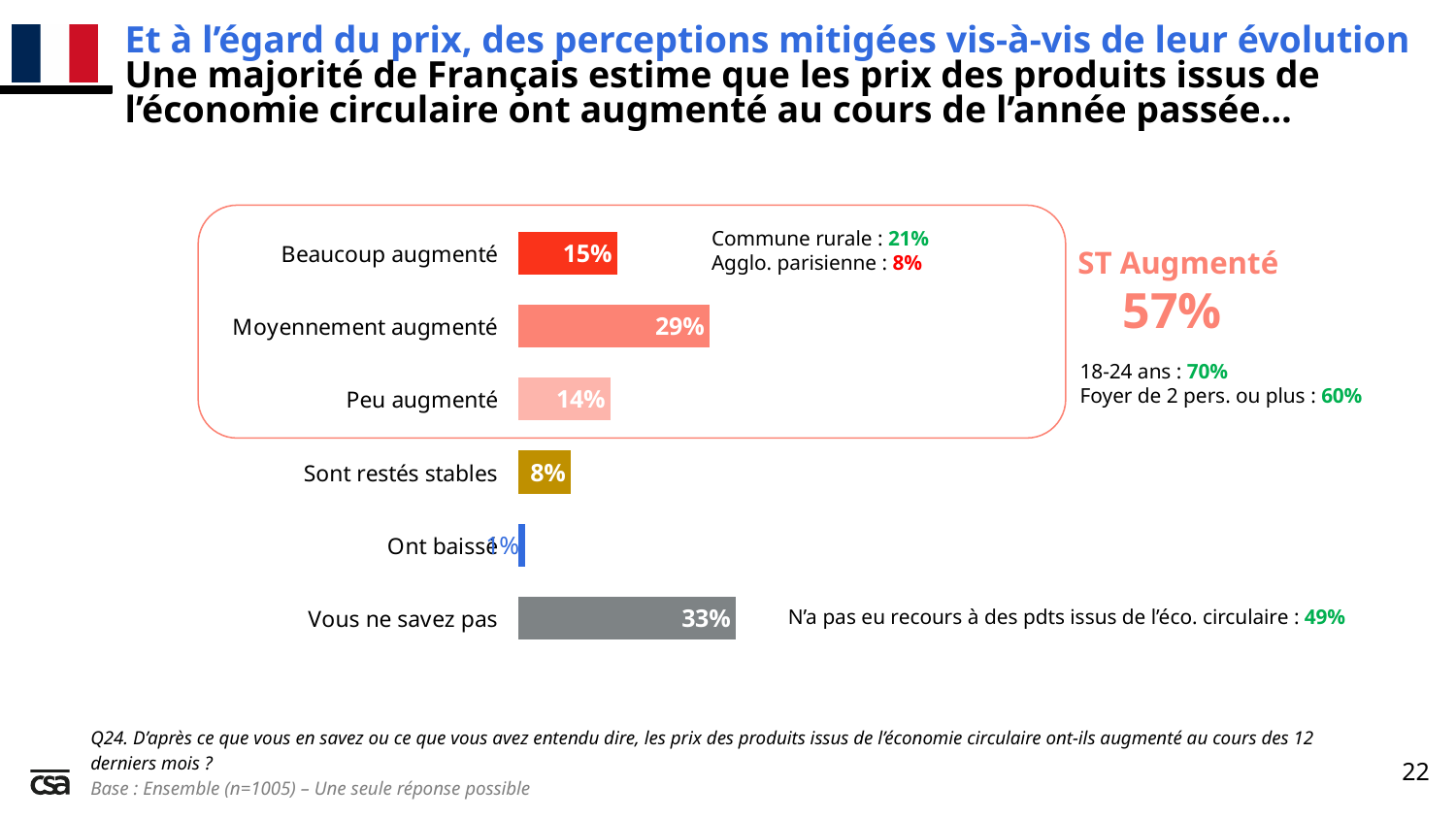
What is the value for "Moyennement augmenté"? 29% What is the value for "Sont restés stables"? 8% What is the "ST Augmenté" total shown next to the chart? 57% Which category has the highest value? Vous ne savez pas What is the value for "Peu augmenté"? 14% Which is larger, "Beaucoup augmenté" or "Peu augmenté"? Beaucoup augmenté What kind of chart is shown on the slide? Bar chart What is the value for "Beaucoup augmenté" among "Commune rurale" respondents, as noted next to the chart? 21% How many categories are shown in the chart? 6 Which category has the lowest value? Ont baissé What is the value for "Vous ne savez pas"? 33% What is the difference between "Moyennement augmenté" and "Beaucoup augmenté"? 14%